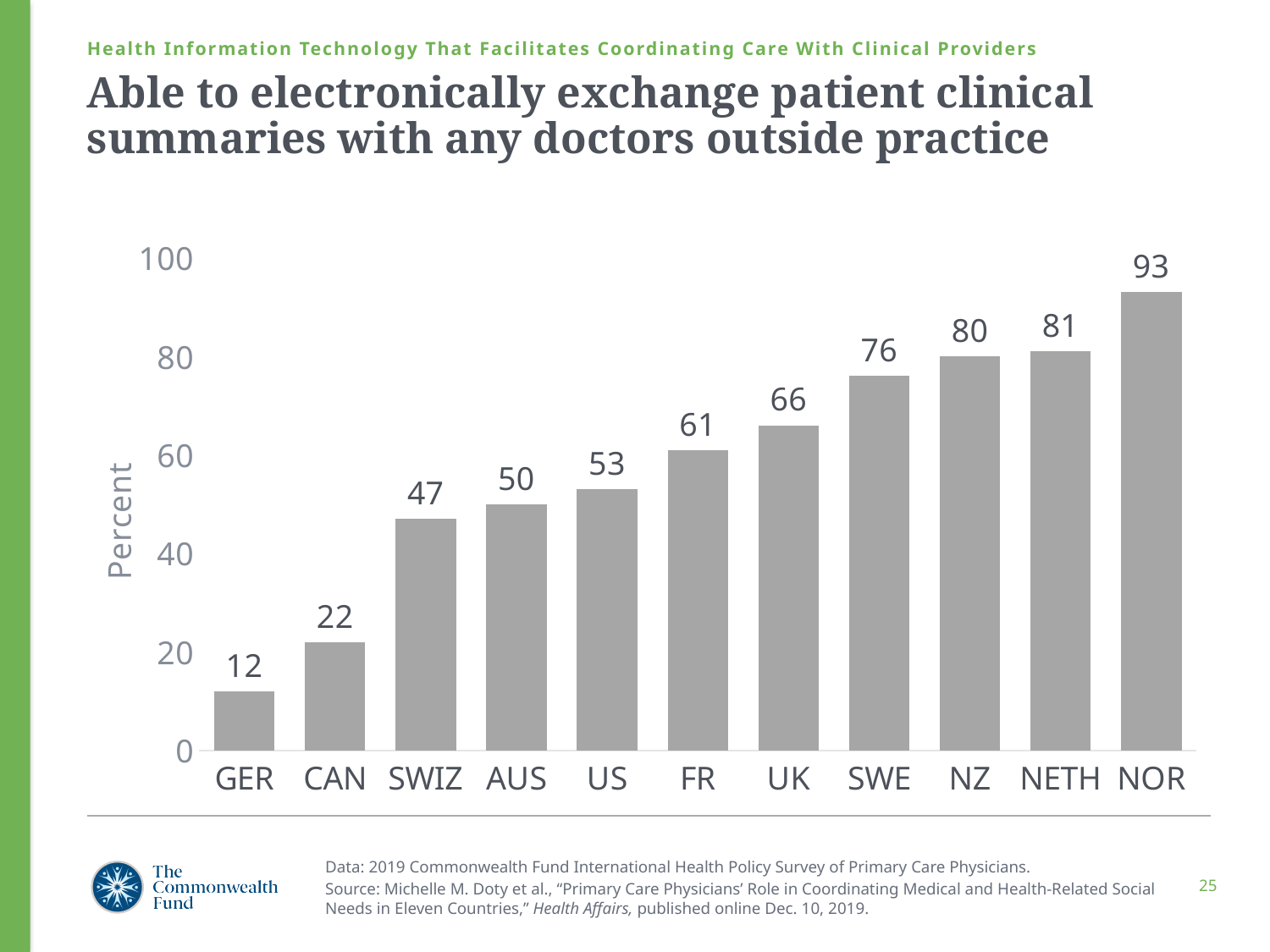
What is the value for GER? 12 What is the difference between the values for NOR and GER? 81 What is the difference between the values for UK and FR? 5 Which country has the lowest value? GER How many countries are shown on the chart? 11 What kind of chart is shown on the slide? bar chart Which is larger, the value for CAN or the value for SWIZ? SWIZ Which country has the highest value? NOR Do the values rise or fall from left to right along the x axis? rise What is the value for SWE? 76 What is the value for the US? 53 Is the value for NZ greater or less than 60? greater